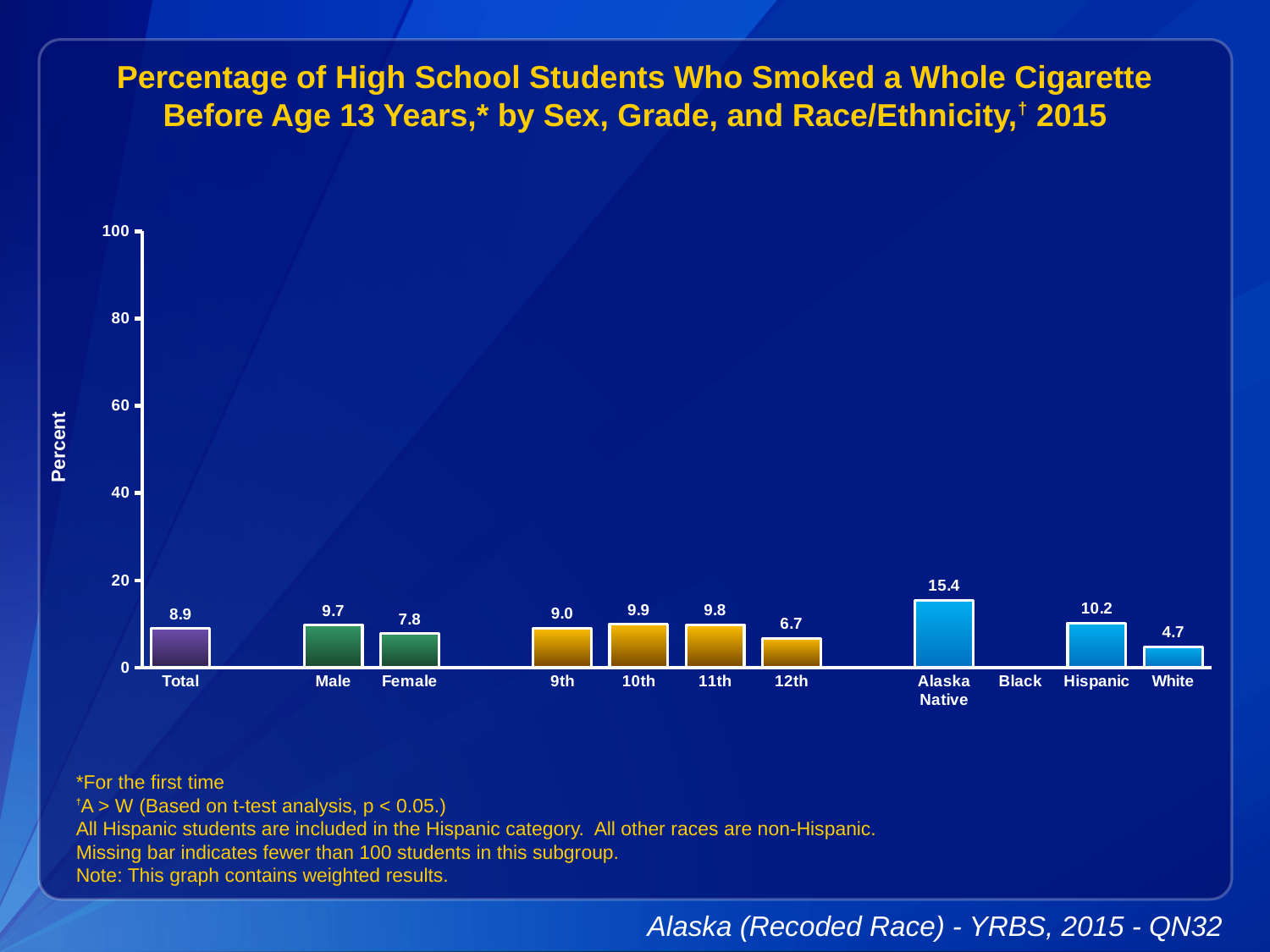
Is the value for Alaska Native greater or less than 20? less Which is larger, the value for Hispanic or the value for White? Hispanic Which category has the highest value? Alaska Native What is the difference between the values for Male and Female? 1.9 How many bars are plotted on the chart? 10 Which category has the lowest value among the bars shown? White What is the value for Total? 8.9 What kind of chart is shown on the slide? bar chart What is the value for Alaska Native? 15.4 What is the value for 12th grade? 6.7 What is the value for Female? 7.8 Which category label has no bar plotted? Black